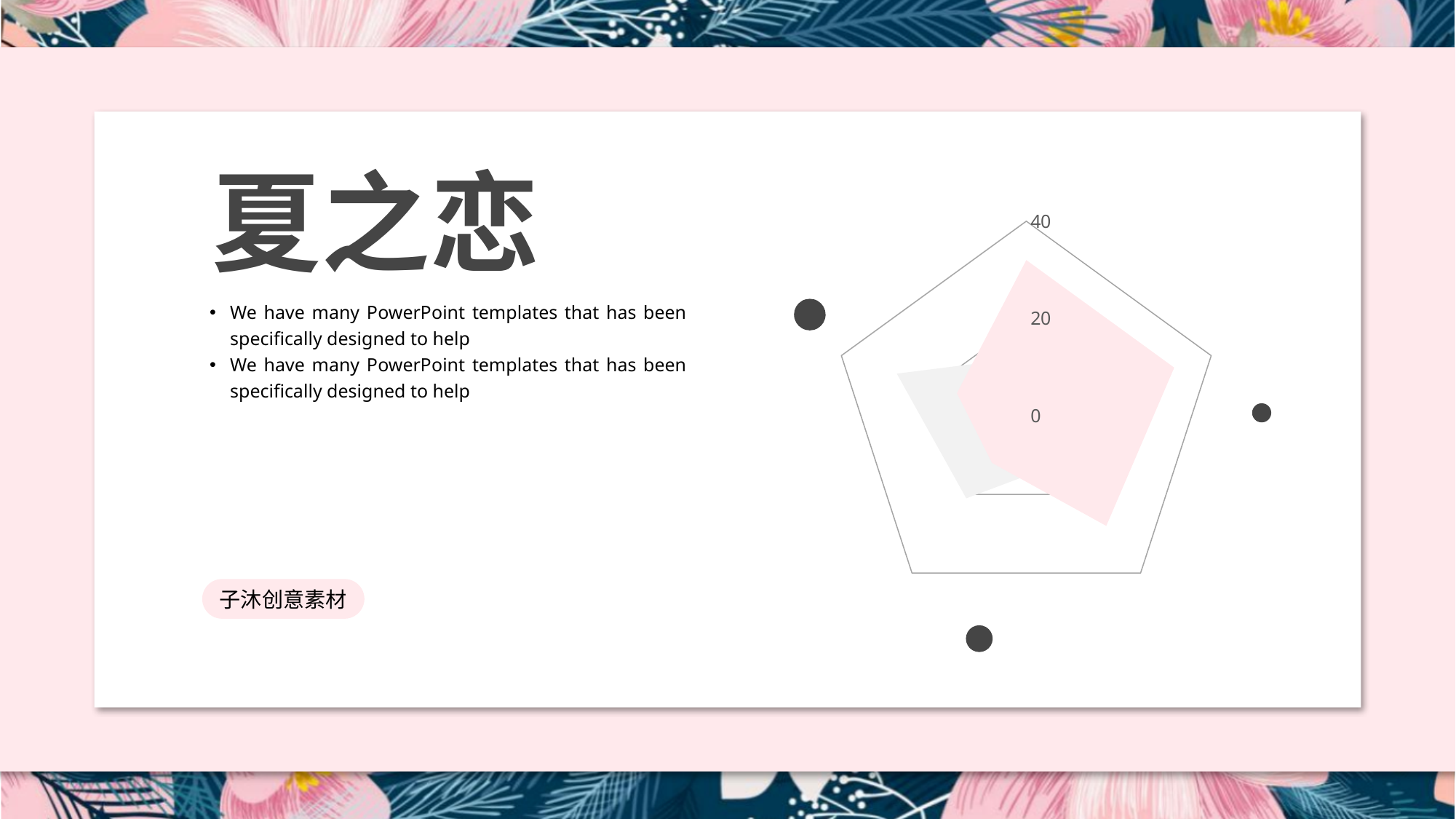
How many data series are plotted on the radar chart? 2 Is the largest value of the pink series on the radar chart greater or less than 20? greater What is the highest value labelled on the radar chart's axis? 40 How many axes (categories) does the radar chart have? 5 What colours are the two filled areas on the radar chart? pink and grey What kind of chart is shown on the slide? radar chart